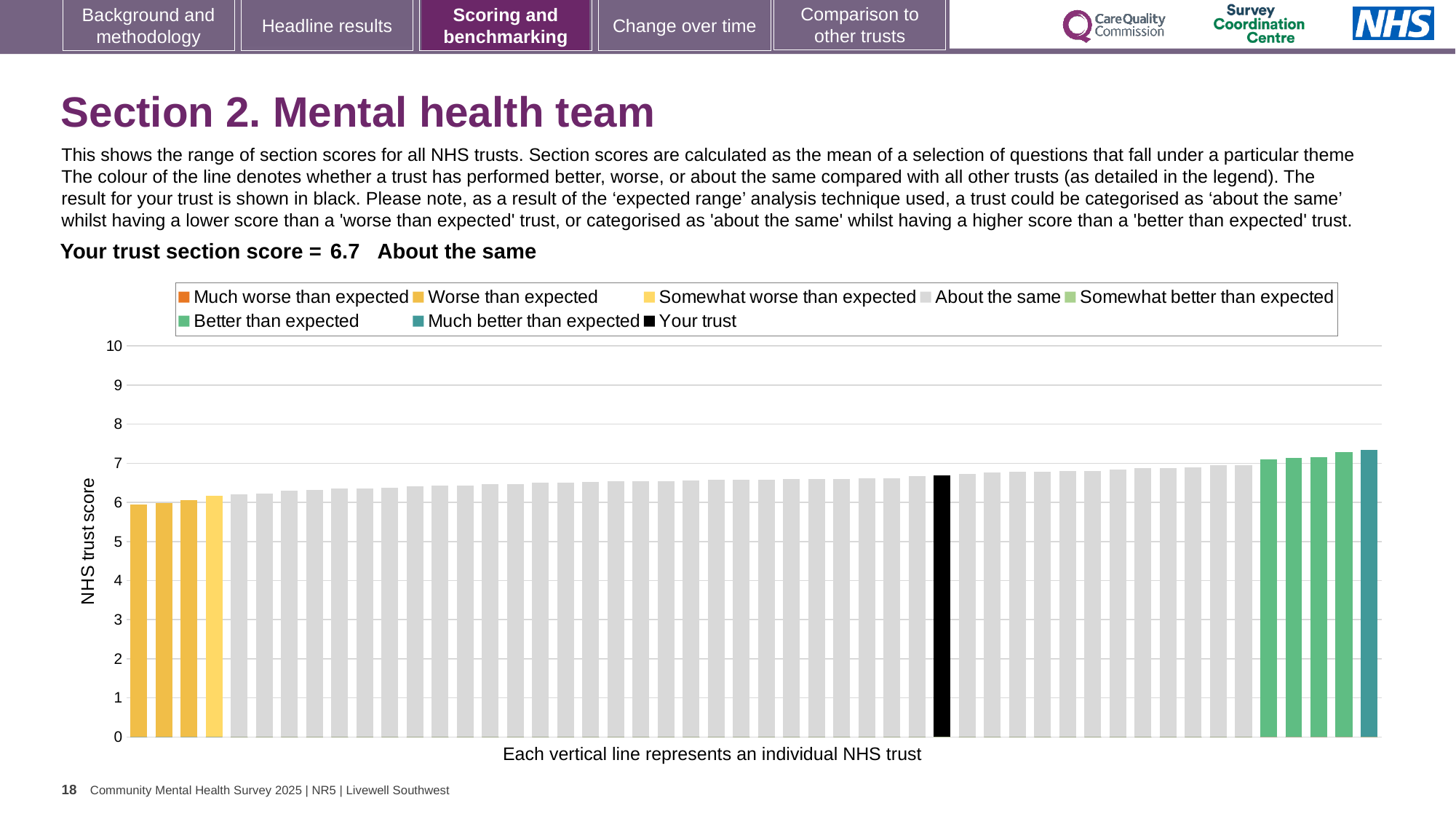
How many entries does the chart legend list? 8 What is the label on the vertical axis of the chart? NHS trust score Is the value of the black 'Your trust' bar greater or less than 7? less Which category is your trust's section score placed in? About the same How many bars are coloured as 'Better than expected'? 4 What is the section score for your trust? 6.7 Is the value of the shortest bar in the chart greater or less than 5? greater What kind of chart is shown on the slide? Bar chart Do the bar values rise or fall from left to right across the chart? Rise Is the value of the tallest bar in the chart greater or less than 7? greater Which legend category does the tallest bar belong to? Much better than expected How many bars are coloured as 'Worse than expected'? 3